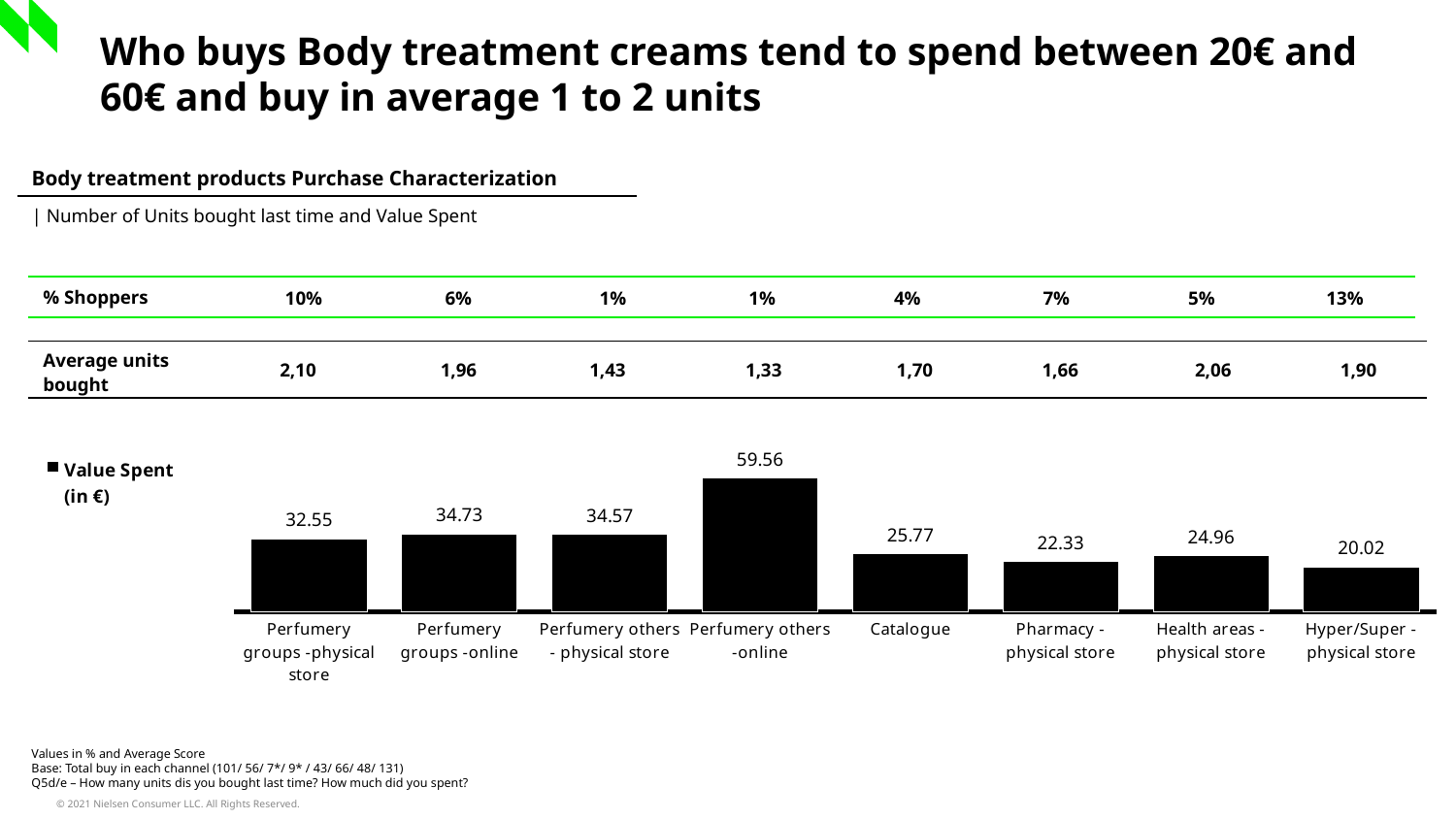
How many channels are shown in the Value Spent chart? 8 What is the legend entry of the chart? Value Spent (in €) What is the value spent (in €) for Perfumery groups - physical store? 32.55 What is the difference in value spent between Perfumery others - online and Perfumery groups - physical store? 27.01 What is the value spent (in €) for Catalogue? 25.77 Which channel has the lowest value spent? Hyper/Super - physical store What is the difference in value spent between Catalogue and Pharmacy - physical store? 3.44 Which has a higher value spent, Health areas - physical store or Hyper/Super - physical store? Health areas - physical store Which channel has the highest value spent? Perfumery others - online What is the value spent (in €) for Perfumery others - online? 59.56 What is the value spent (in €) for Hyper/Super - physical store? 20.02 What kind of chart is used to show Value Spent? Bar chart